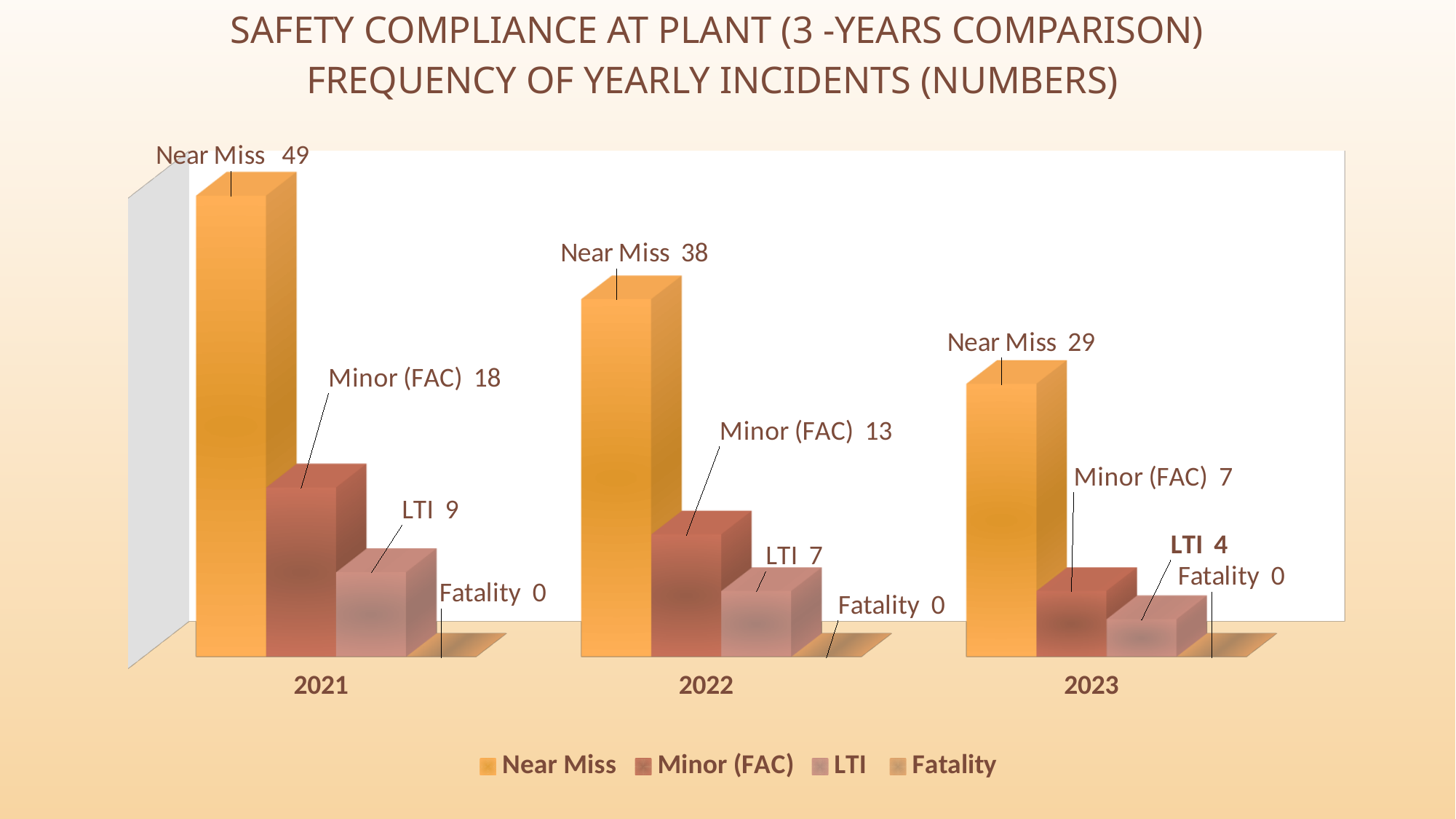
Which year has the lowest Minor (FAC) value? 2023 How many years are shown on the x axis? 3 What is the Minor (FAC) value for 2022? 13 What kind of chart is shown on the slide? Bar chart What is the Near Miss value for 2021? 49 Which year has the highest Near Miss value? 2021 How many series does the legend list? 4 What is the Fatality value for 2022? 0 What is the LTI value for 2023? 4 Which is larger, the LTI value for 2021 or the LTI value for 2022? LTI for 2021 What is the difference between the Near Miss values for 2021 and 2023? 20 Do the Near Miss values rise or fall from 2021 to 2023? Fall